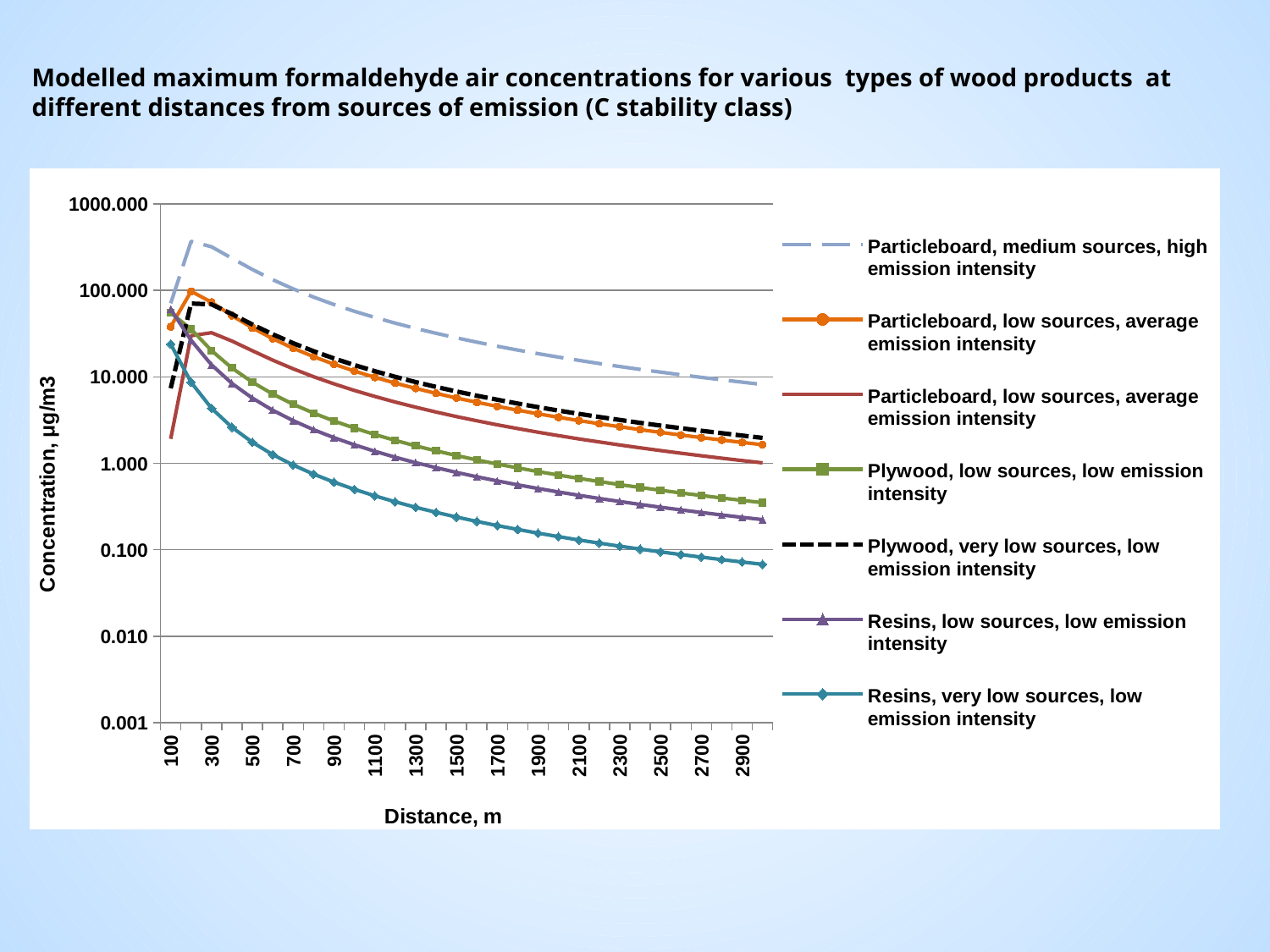
Which series has the lowest concentration at 2900 m? Resins, very low sources, low emission intensity Do the concentrations rise or fall as distance increases beyond 300 m? Fall What is the title of the y axis? Concentration, µg/m3 How many series does the legend list? 7 What kind of chart is shown on the slide? Line chart At 2900 m, which is higher: Plywood, low sources, low emission intensity or Resins, low sources, low emission intensity? Plywood, low sources, low emission intensity Is the value for Resins, very low sources, low emission intensity at 100 m greater or less than 10.000? greater What is the title of the x axis? Distance, m Is the value for Plywood, low sources, low emission intensity at 2900 m greater or less than 1.000? less Which series has the highest concentration at 2900 m? Particleboard, medium sources, high emission intensity Is the value for Resins, very low sources, low emission intensity at 2900 m greater or less than 0.100? less